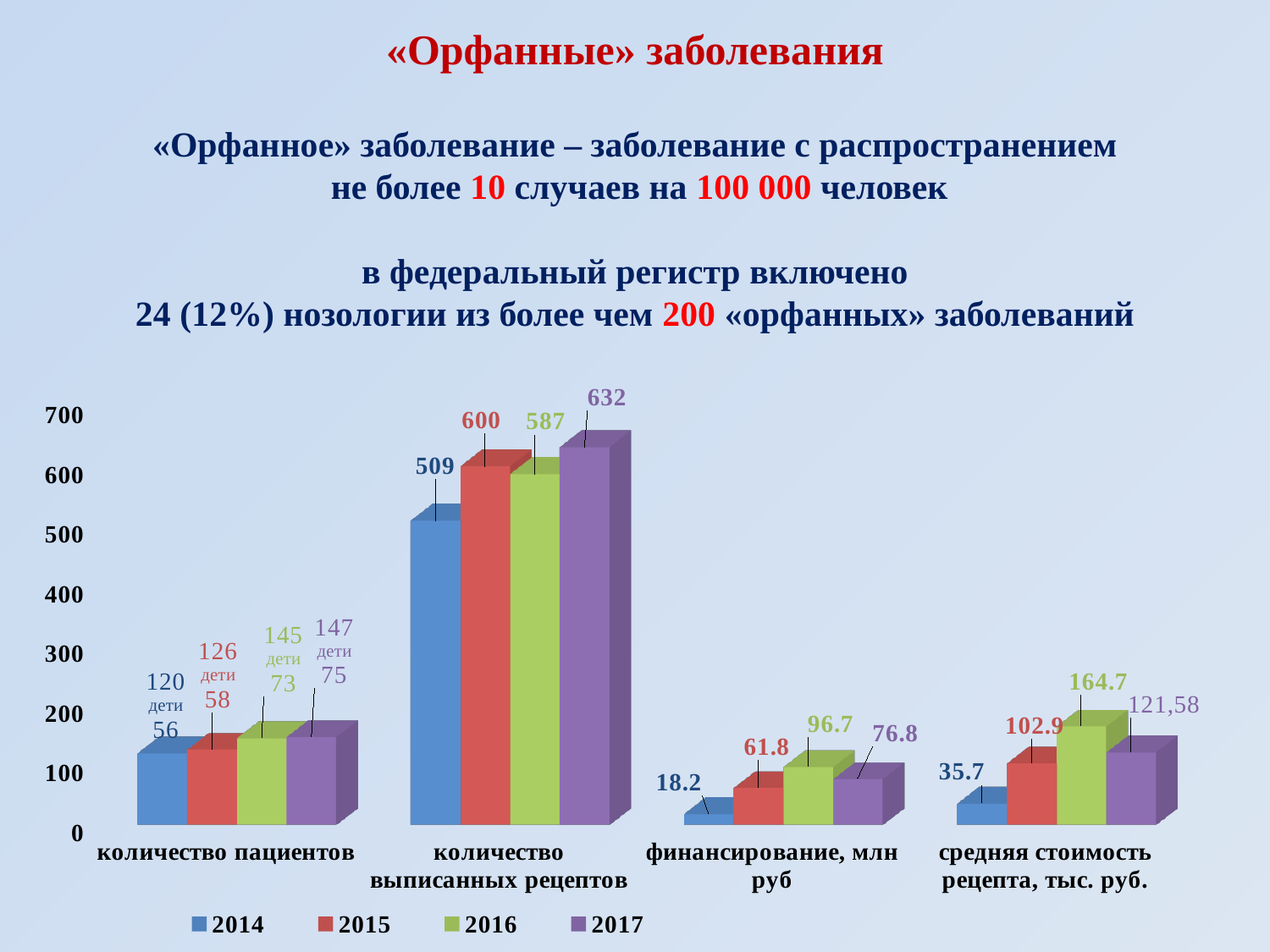
What kind of chart is shown on the slide? bar chart Which year has the lowest value in the category "финансирование, млн руб"? 2014 What is the value for 2017 in the category "количество выписанных рецептов"? 632 What is the value for 2016 in the category "средняя стоимость рецепта, тыс. руб."? 164.7 Which legend entry is shown in purple? 2017 How many series does the legend list? 4 What is the value for 2015 in the category "количество пациентов"? 126 How many categories are shown on the x axis? 4 In the category "средняя стоимость рецепта, тыс. руб.", which is larger: the value for 2016 or the value for 2017? 2016 What is the difference between the 2017 and 2014 values in the category "количество пациентов"? 27 What is the value for 2014 in the category "финансирование, млн руб"? 18.2 Which year has the highest value in the category "количество выписанных рецептов"? 2017